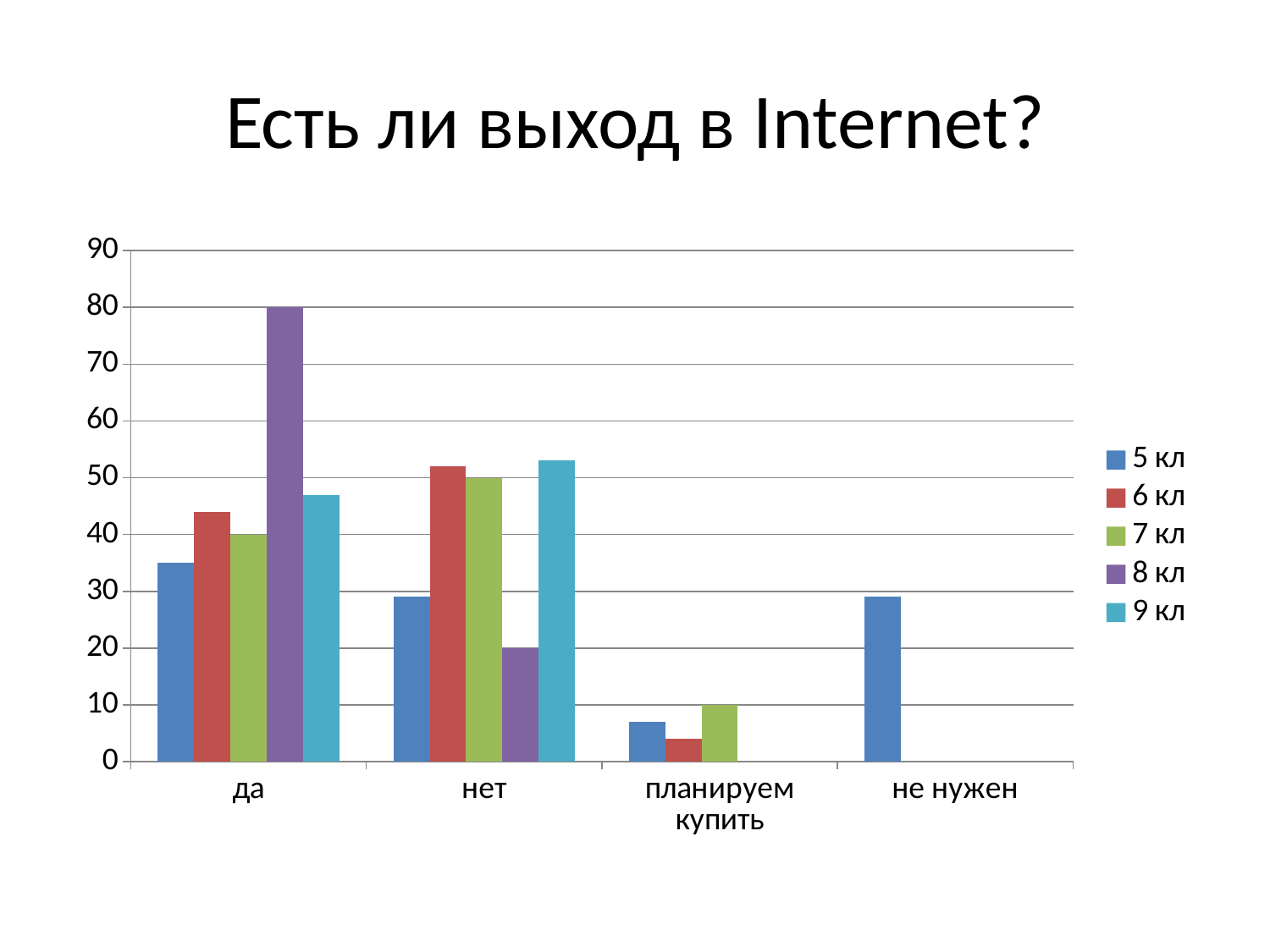
Which is larger: the value for 9 кл in "нет" or the value for 9 кл in "да"? 9 кл in "нет" How many categories are shown on the x axis? 4 What is the title of the chart? Есть ли выход в Internet? What is the value for 8 кл in the category "да"? 80 Which series has the highest value for the category "да"? 8 кл What is the value for 7 кл in the category "нет"? 50 Which series has the lowest value for the category "нет"? 8 кл How many series does the legend list? 5 Is the value for 6 кл in the category "планируем купить" greater or less than 10? less What kind of chart is shown on the slide? bar chart Is the value for 5 кл in the category "да" greater or less than 30? greater What is the value for 8 кл in the category "нет"? 20